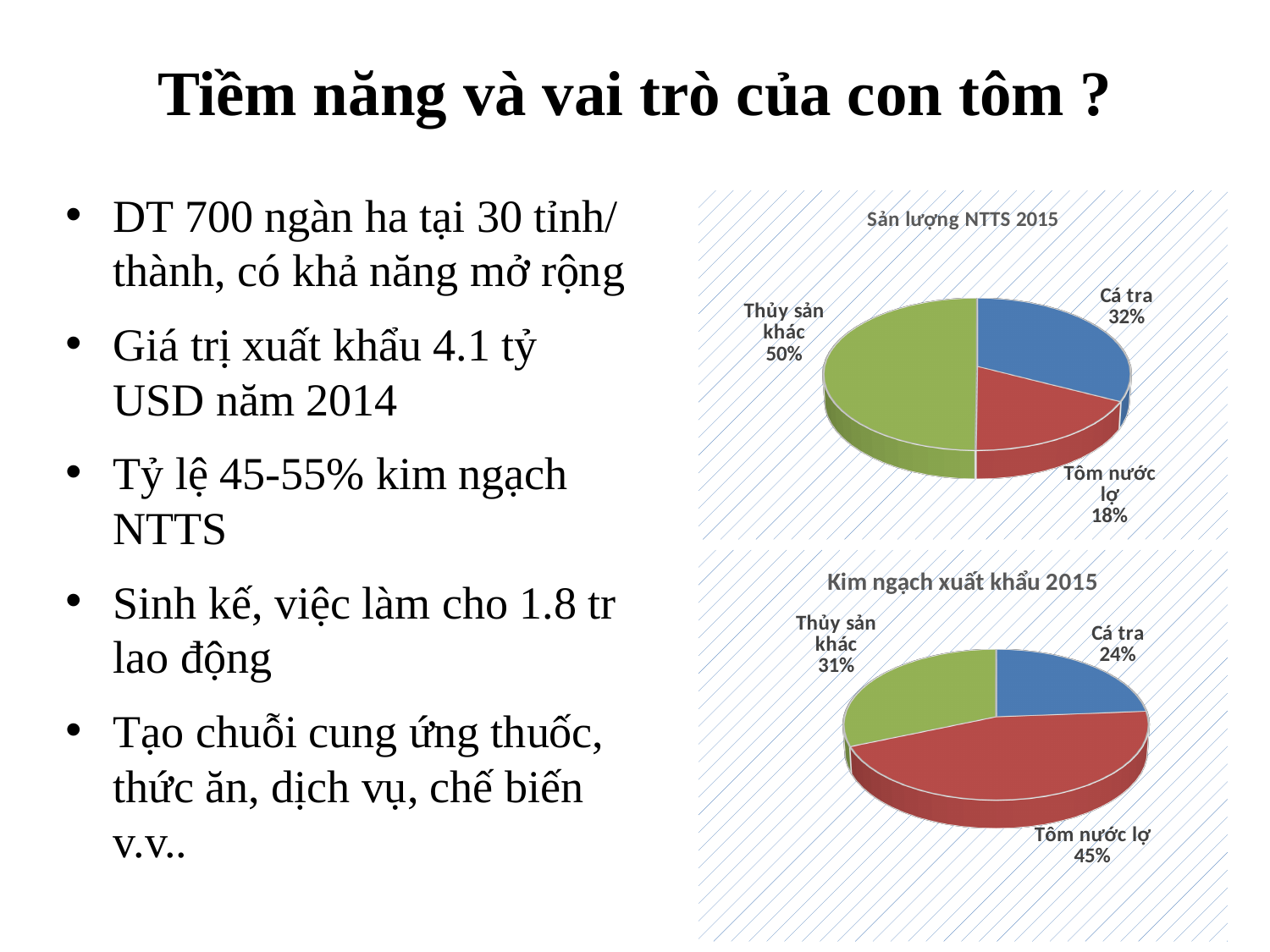
In the 'Kim ngạch xuất khẩu 2015' chart, which category has the largest share? Tôm nước lợ What kind of chart is the 'Kim ngạch xuất khẩu 2015' chart? Pie chart In the 'Sản lượng NTTS 2015' chart, what share does Tôm nước lợ have? 18% In the 'Sản lượng NTTS 2015' chart, what share does Cá tra have? 32% How many categories does the 'Sản lượng NTTS 2015' chart show? 3 In the 'Kim ngạch xuất khẩu 2015' chart, which is larger: the share of Cá tra or the share of Thủy sản khác? Thủy sản khác In the 'Sản lượng NTTS 2015' chart, which category has the smallest share? Tôm nước lợ In the 'Sản lượng NTTS 2015' chart, what is the difference between the shares of Cá tra and Tôm nước lợ? 14% In the 'Kim ngạch xuất khẩu 2015' chart, which category has the smallest share? Cá tra In the 'Kim ngạch xuất khẩu 2015' chart, what share does Tôm nước lợ have? 45% In the 'Kim ngạch xuất khẩu 2015' chart, what share does Thủy sản khác have? 31% In the 'Sản lượng NTTS 2015' chart, which category has the largest share? Thủy sản khác